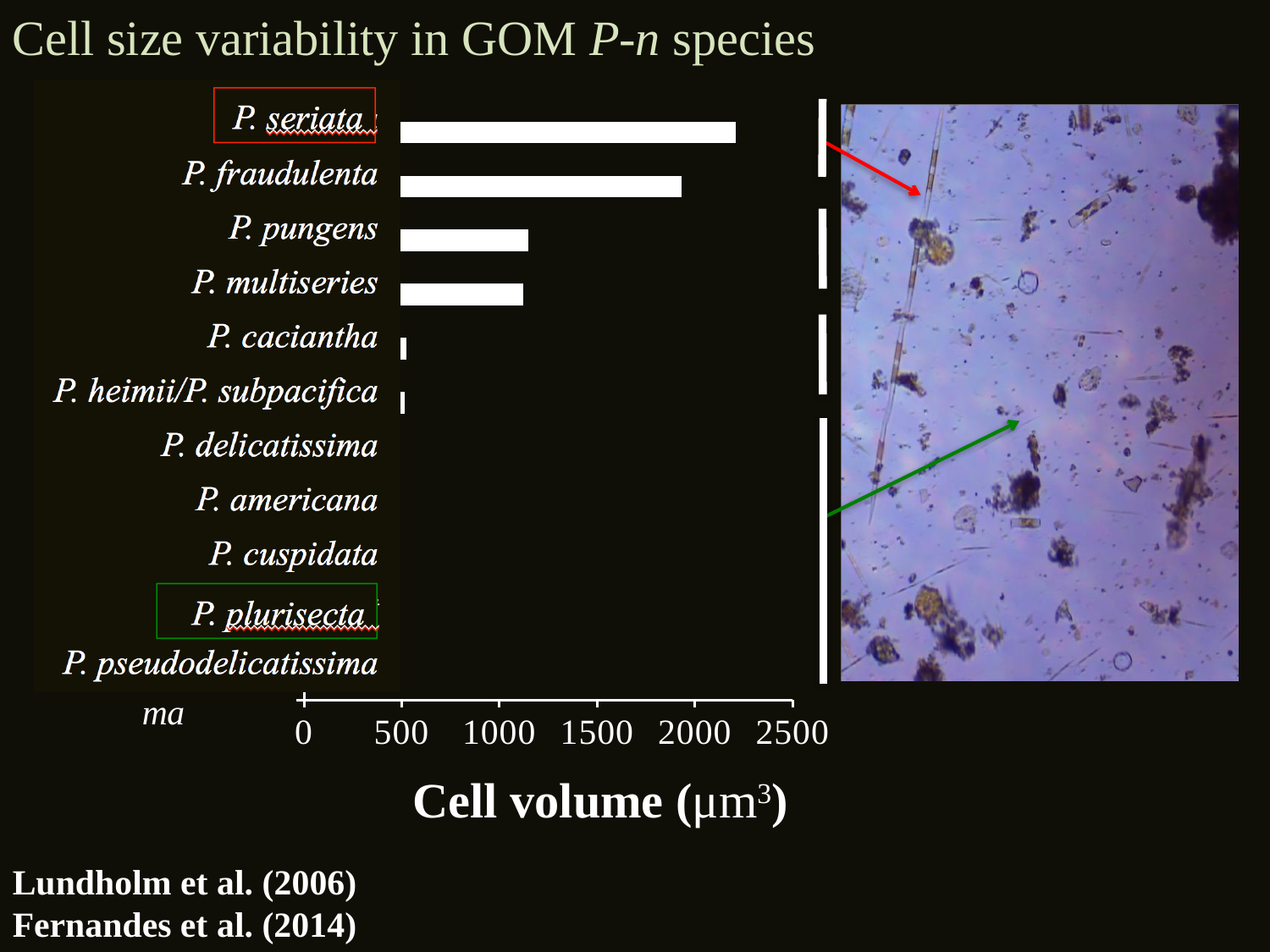
Which has a larger cell volume, P. seriata or P. fraudulenta? P. seriata Is the cell volume for P. multiseries greater or less than 1500? less What kind of chart is shown on the slide? bar chart Which species has the largest cell volume in the chart? P. seriata Is the cell volume for P. seriata greater or less than 2000? greater Is the cell volume for P. pungens greater or less than 1500? less Which has a larger cell volume, P. fraudulenta or P. pungens? P. fraudulenta Do the bar lengths increase or decrease going from the top species to the bottom species? decrease What is the label of the x axis of the chart? Cell volume (μm³) How many species categories are listed on the y axis of the chart? 11